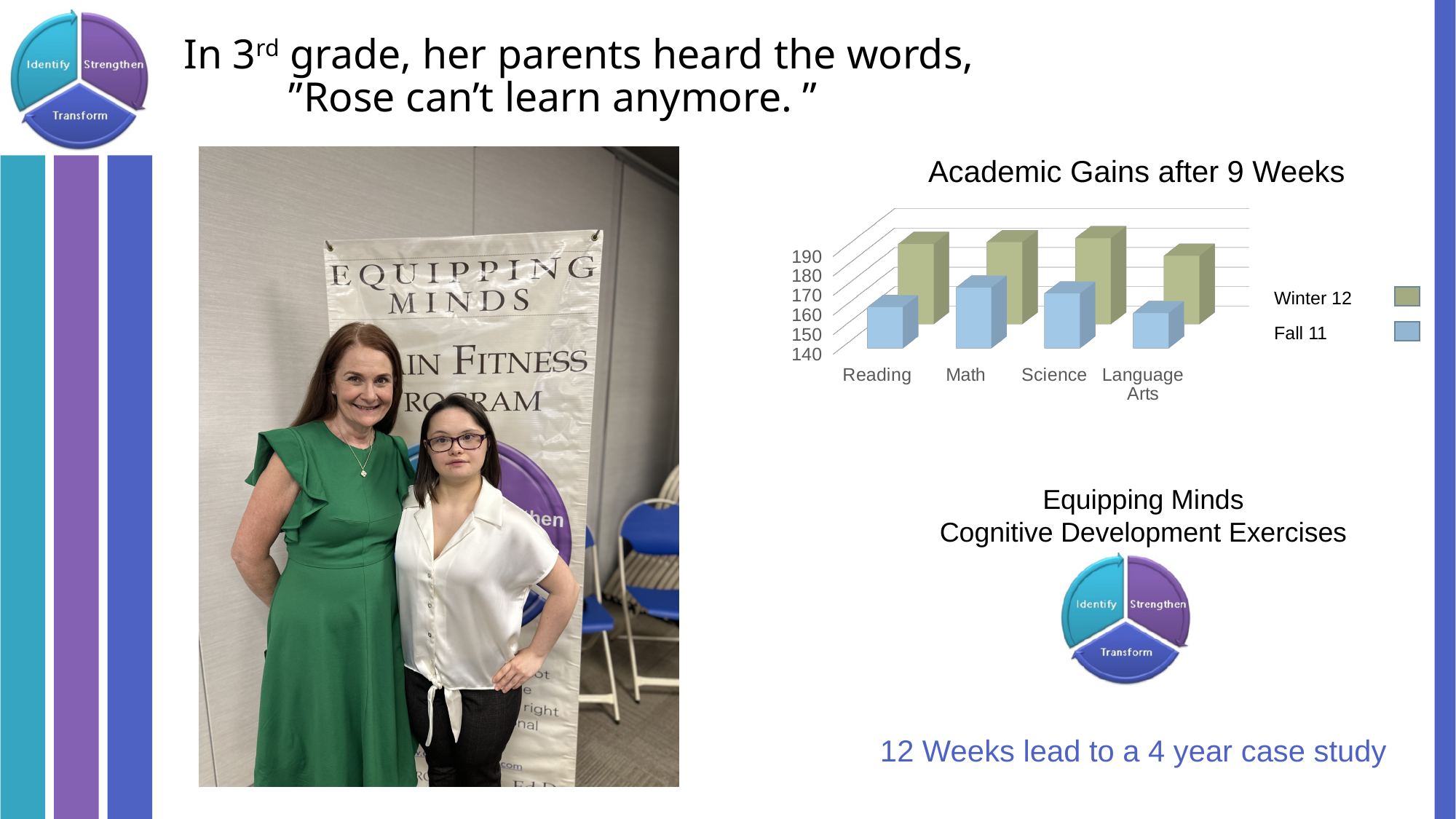
For Reading, which series has the larger value, Fall 11 or Winter 12? Winter 12 How many series does the chart's legend list? 2 How many subject categories are shown on the x axis of the chart? 4 Is the Fall 11 value for Reading greater or less than 180? less Which two series are listed in the chart's legend? Winter 12 and Fall 11 Is the Winter 12 value for Science greater or less than 180? greater Is the Fall 11 value for Language Arts greater or less than 170? less Which category has the lowest Fall 11 value? Language Arts For Language Arts, which series has the larger value, Fall 11 or Winter 12? Winter 12 Which category has the lowest Winter 12 value? Language Arts What type of chart is shown on the slide? Bar chart What is the title of the chart? Academic Gains after 9 Weeks